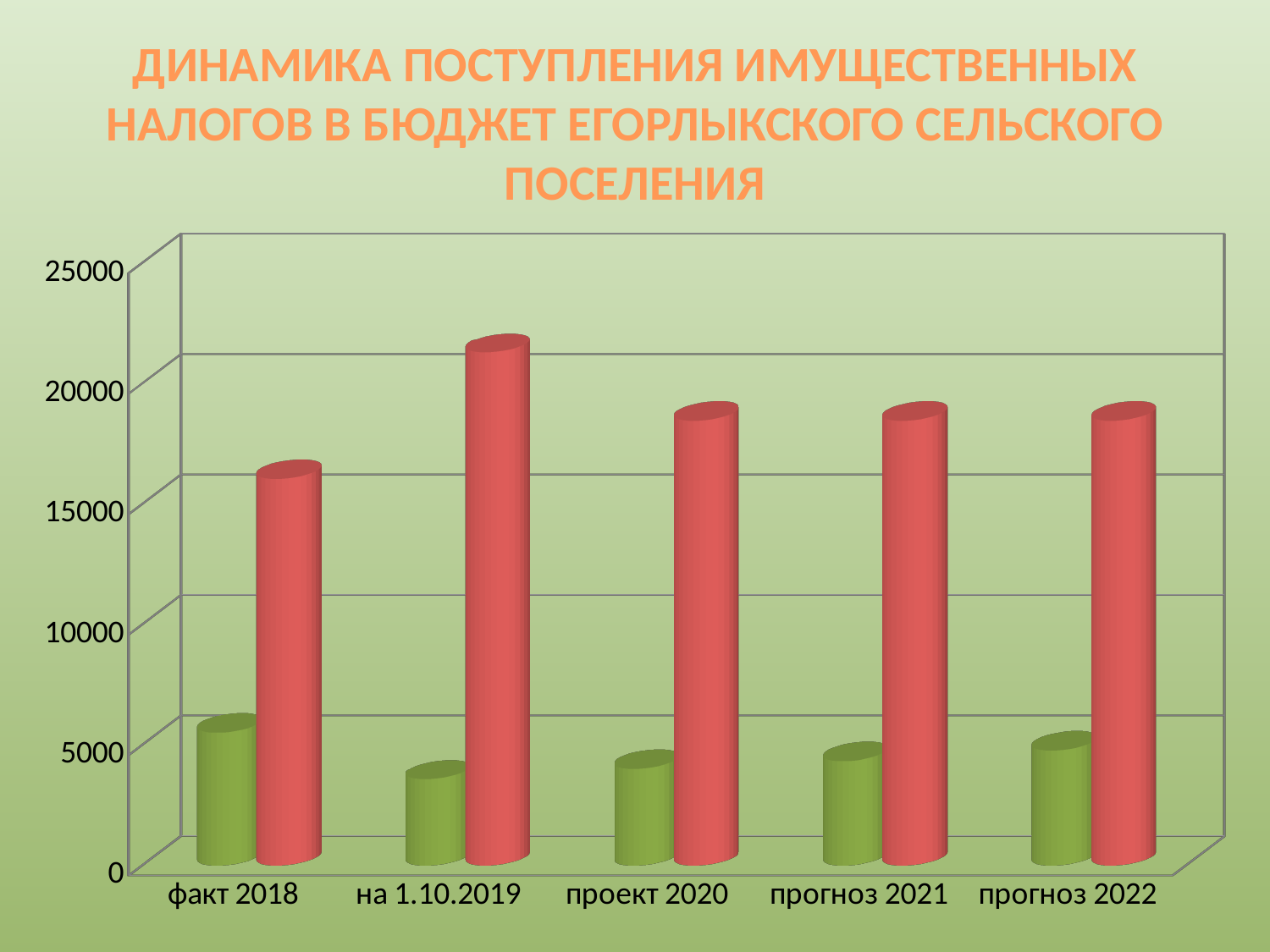
Which is larger: the red bar for факт 2018 or the red bar for проект 2020? проект 2020 Is the red bar for на 1.10.2019 greater or less than 20000? greater Which category has the tallest red bar? на 1.10.2019 Which category has the shortest red bar? факт 2018 What type of chart is shown on the slide? bar chart Is the green bar for на 1.10.2019 greater or less than 5000? less Is the red bar for факт 2018 greater or less than 15000? greater What is the highest value shown on the vertical axis? 25000 Which category has the shortest green bar? на 1.10.2019 Which category has the tallest green bar? факт 2018 How many categories are shown along the x axis? 5 How many bars are shown for each category? 2